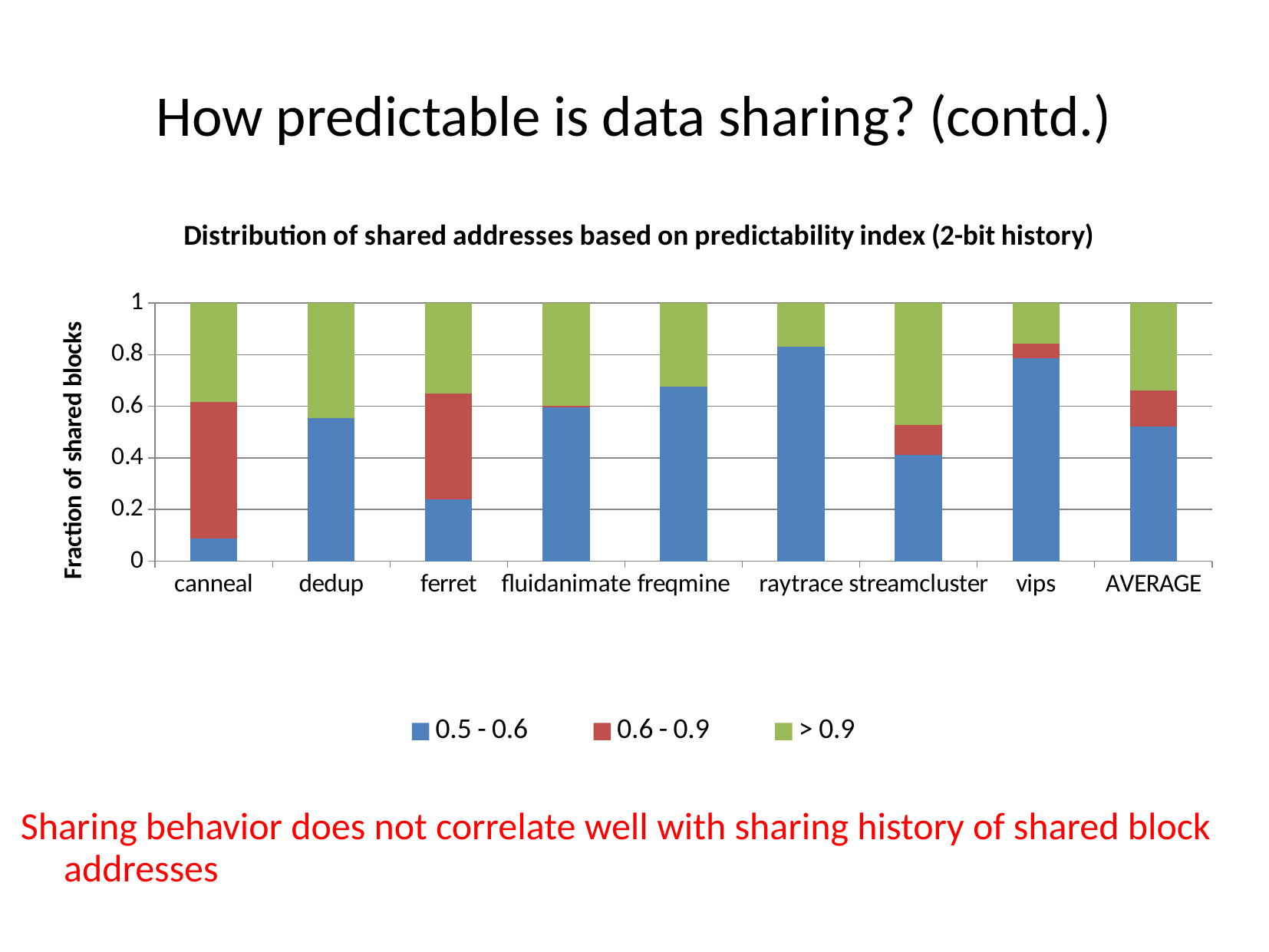
What is the label of the y axis? Fraction of shared blocks Is the 0.5 - 0.6 value for canneal greater or less than 0.2? less Which category has the largest 0.5 - 0.6 (blue) segment? raytrace Which has a larger 0.5 - 0.6 (blue) segment, dedup or ferret? dedup What type of chart is shown on the slide? Stacked bar chart Is the 0.5 - 0.6 value for raytrace greater or less than 0.8? greater Which category has the smallest 0.5 - 0.6 (blue) segment? canneal How many categories are shown along the x axis of the chart? 9 What is the total height of the stacked bar for AVERAGE? 1 Which category has the largest 0.6 - 0.9 (red) segment? canneal How many series does the chart's legend list? 3 What is the title of the chart? Distribution of shared addresses based on predictability index (2-bit history)